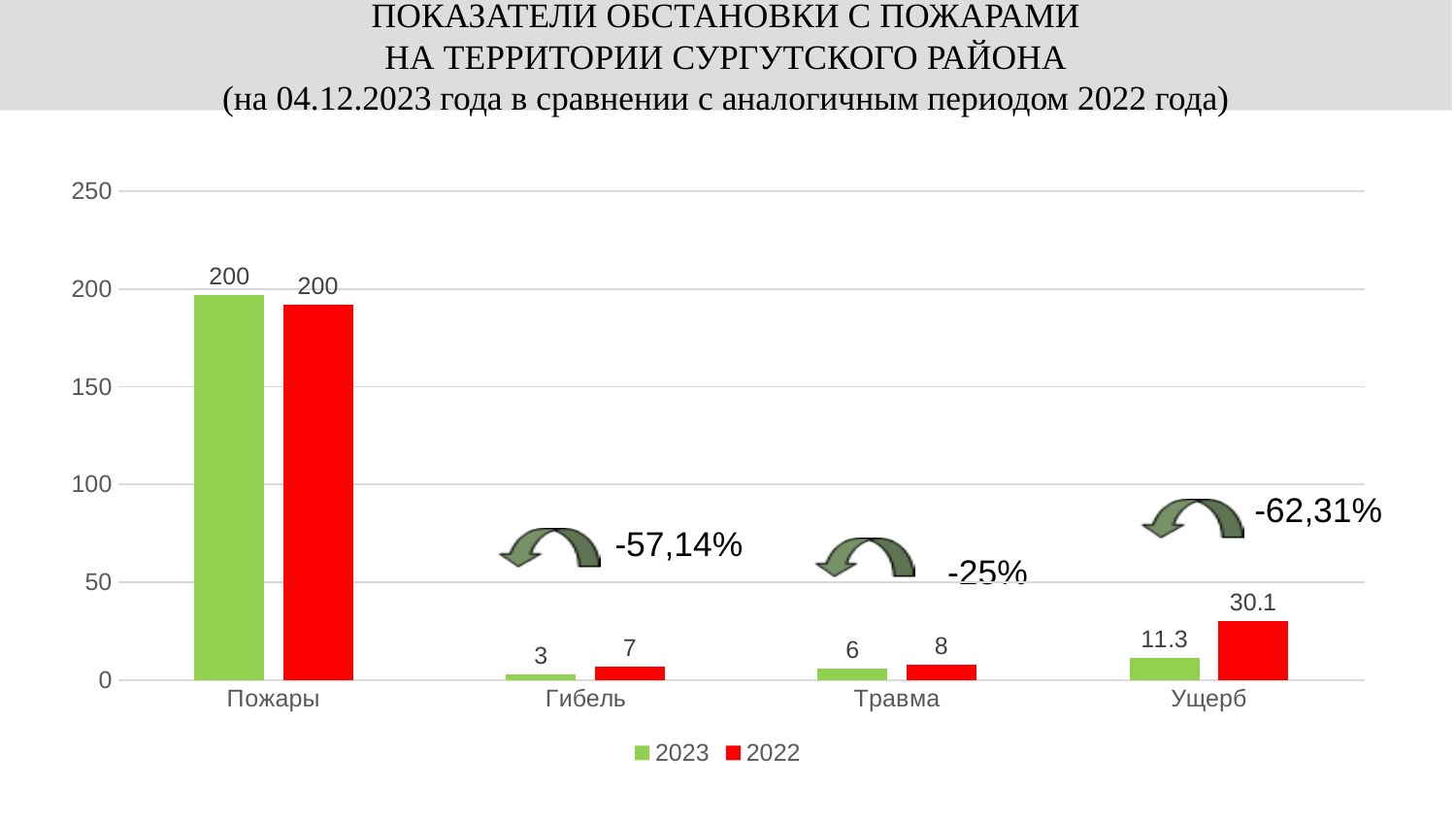
What kind of chart is shown on the slide? Bar chart How many series does the legend list? 2 How many categories are shown on the x axis? 4 Which category has the lowest value in the 2023 series? Гибель What is the value for Ущерб in the 2022 series? 30.1 Which category has the highest value in the 2022 series? Пожары Which is larger for Травма: the 2023 value or the 2022 value? 2022 What is the value for Гибель in the 2023 series? 3 What is the value for Травма in the 2022 series? 8 What is the value for Пожары in the 2023 series? 200 What is the difference between the 2022 and 2023 values for Ущерб? 18.8 What is the difference between the 2022 and 2023 values for Гибель? 4